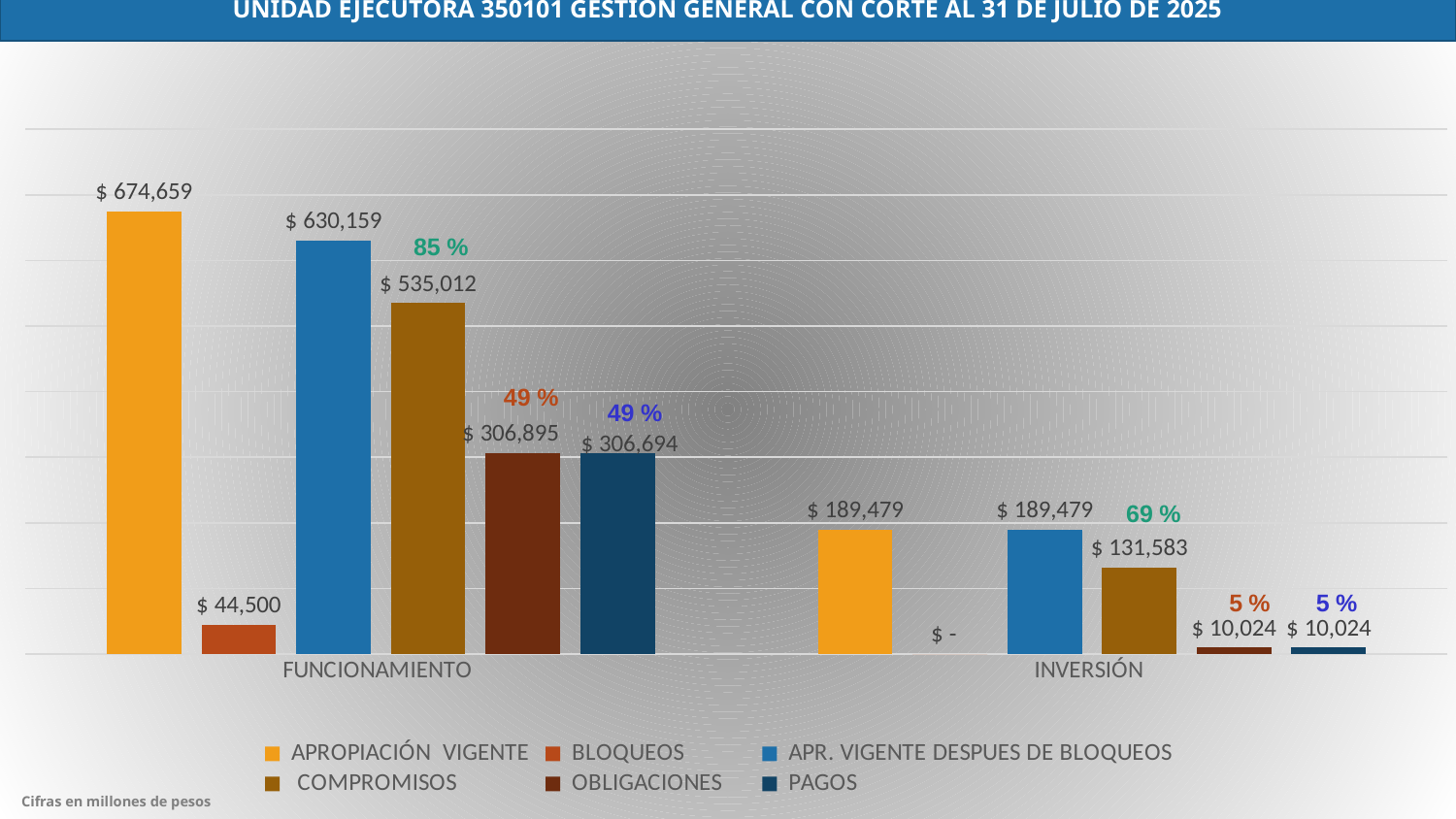
Which series has the highest value for FUNCIONAMIENTO? APROPIACIÓN VIGENTE How many series does the legend list? 6 What is the difference between APROPIACIÓN VIGENTE and APR. VIGENTE DESPUES DE BLOQUEOS for FUNCIONAMIENTO? $ 44,500 What is the value of PAGOS for INVERSIÓN? $ 10,024 Which is larger: OBLIGACIONES for FUNCIONAMIENTO or COMPROMISOS for INVERSIÓN? OBLIGACIONES for FUNCIONAMIENTO What type of chart is shown on the slide? Bar chart What is the value of BLOQUEOS for FUNCIONAMIENTO? $ 44,500 How many categories are shown on the x axis? 2 Which series has the lowest value for FUNCIONAMIENTO? BLOQUEOS What is the value of APROPIACIÓN VIGENTE for FUNCIONAMIENTO? $ 674,659 What is the difference between COMPROMISOS for FUNCIONAMIENTO and COMPROMISOS for INVERSIÓN? $ 403,429 What is the value of COMPROMISOS for INVERSIÓN? $ 131,583